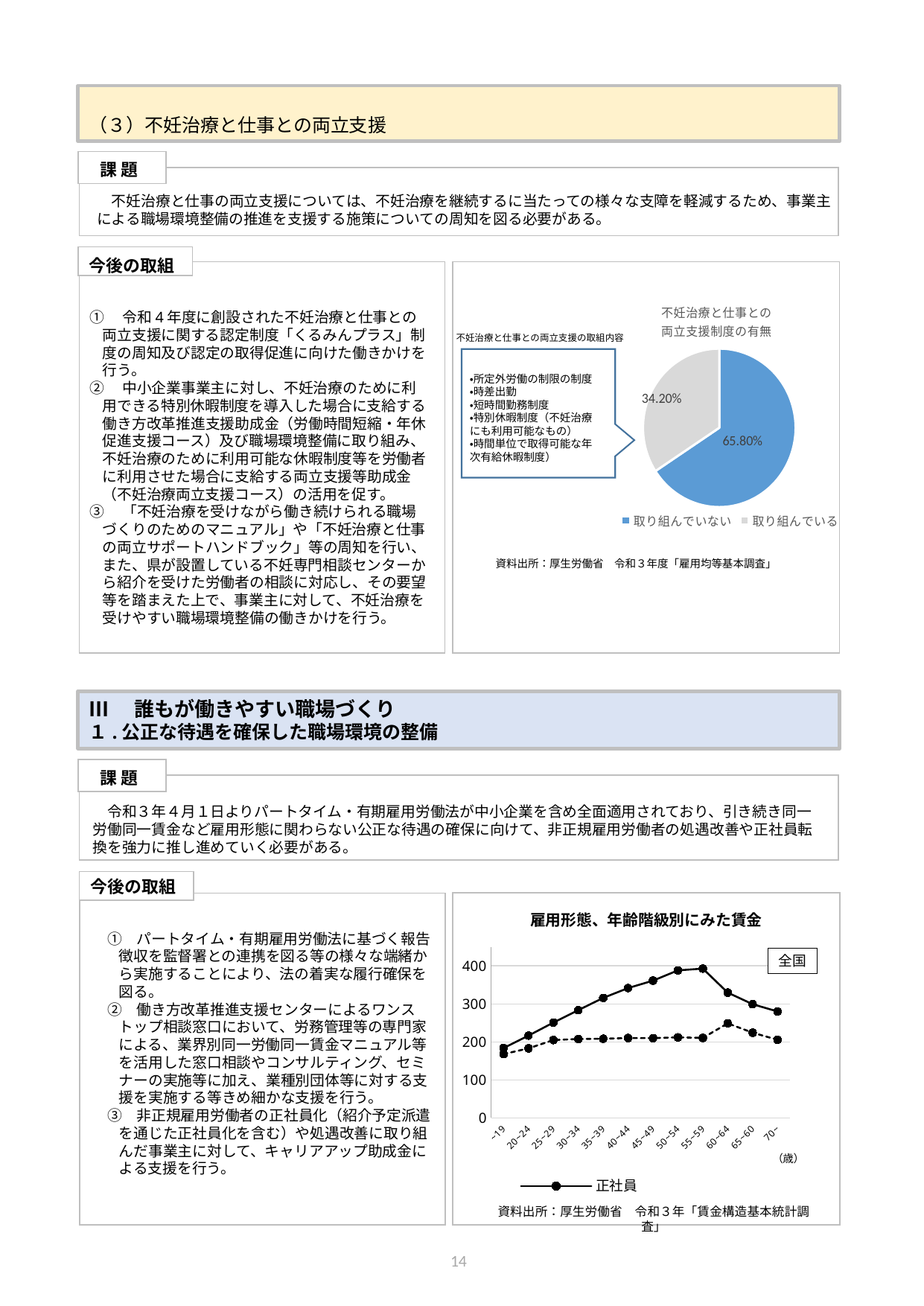
In the line chart titled 雇用形態、年齢階級別にみた賃金, how many age categories are shown on the x axis? 12 In the pie chart titled 不妊治療と仕事との両立支援制度の有無, which slice is larger, 取り組んでいない or 取り組んでいる? 取り組んでいない In the pie chart titled 不妊治療と仕事との両立支援制度の有無, what percentage is shown for 取り組んでいない? 65.80% In the line chart titled 雇用形態、年齢階級別にみた賃金, is the value for 正社員 at 55～59 greater or less than 300? greater In the pie chart titled 不妊治療と仕事との両立支援制度の有無, which colour is used for the 取り組んでいない slice? Blue In the pie chart titled 不妊治療と仕事との両立支援制度の有無, how many slices does the pie have? 2 In the pie chart titled 不妊治療と仕事との両立支援制度の有無, what percentage is shown for 取り組んでいる? 34.20% In the pie chart titled 不妊治療と仕事との両立支援制度の有無, what is the difference in percentage points between 取り組んでいない and 取り組んでいる? 31.60 What kind of chart is the chart titled 雇用形態、年齢階級別にみた賃金? Line chart In the line chart titled 雇用形態、年齢階級別にみた賃金, is the value for 正社員 at 20～24 greater or less than 300? less In the line chart titled 雇用形態、年齢階級別にみた賃金, which age category has the lowest value for 正社員? ～19 In the line chart titled 雇用形態、年齢階級別にみた賃金, does the 正社員 line rise or fall from 20～24 to 50～54? Rise